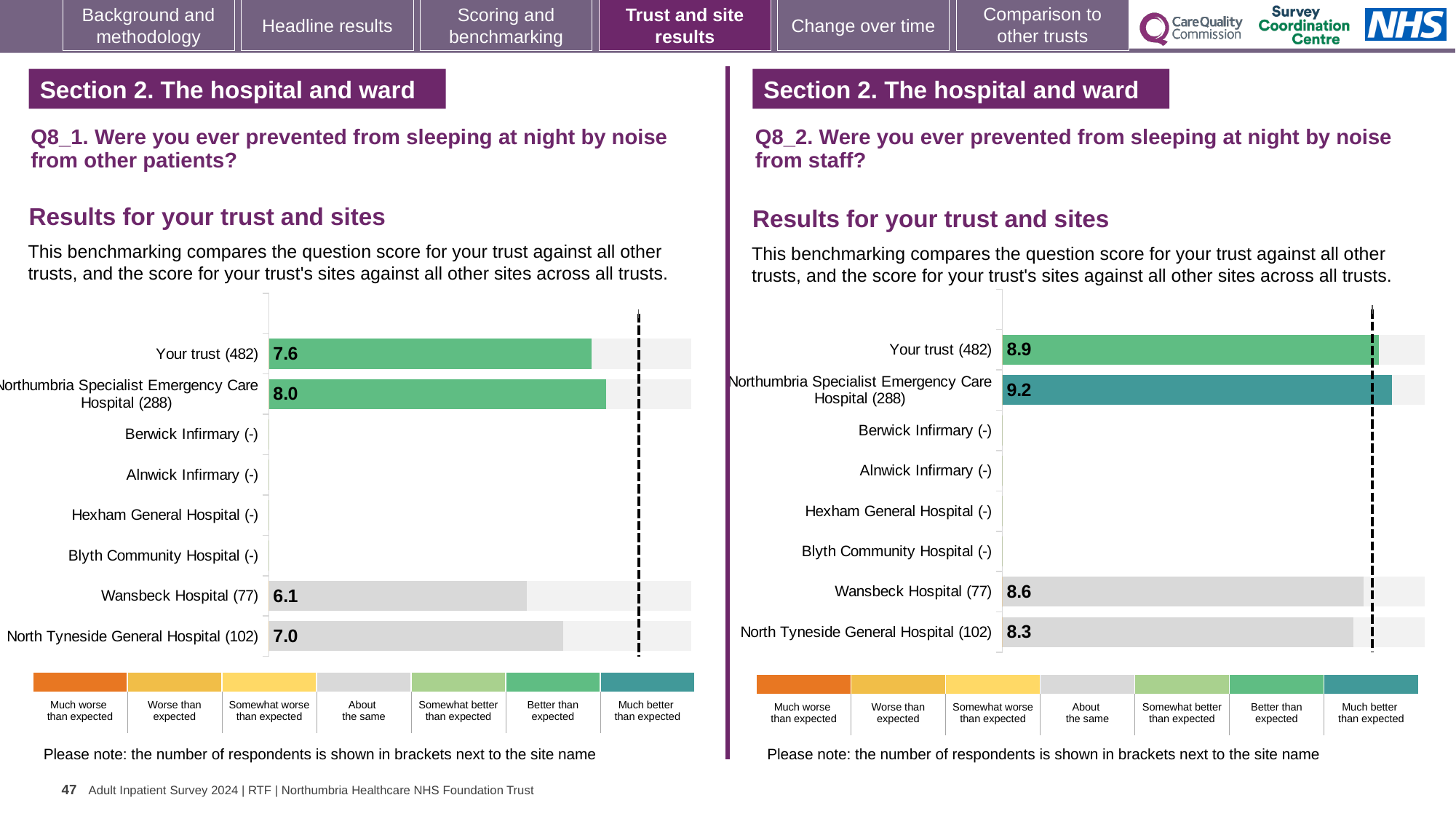
On the Q8_2 chart (right), what is the difference between the scores for Northumbria Specialist Emergency Care Hospital and Your trust? 0.3 On the Q8_2 chart (right), what is the score for North Tyneside General Hospital (102)? 8.3 On the Q8_2 chart (right), which site or trust has the highest score? Northumbria Specialist Emergency Care Hospital (288) On the Q8_1 chart (left), what is the score for Wansbeck Hospital (77)? 6.1 On the Q8_1 chart (left), which site or trust has the lowest score? Wansbeck Hospital (77) On the Q8_1 chart (left), which site or trust has the highest score? Northumbria Specialist Emergency Care Hospital (288) On the Q8_1 chart (left), what is the difference between the scores for Northumbria Specialist Emergency Care Hospital and North Tyneside General Hospital? 1.0 On the Q8_2 chart (right), what is the score for Your trust (482)? 8.9 On the Q8_1 chart (left), what is the score for Your trust (482)? 7.6 What kind of chart is used on the Q8_1 chart (left)? Bar chart On the Q8_1 chart (left), how many sites or trusts have a score bar shown? 4 On the Q8_2 chart (right), which is larger: the score for Wansbeck Hospital or the score for North Tyneside General Hospital? Wansbeck Hospital